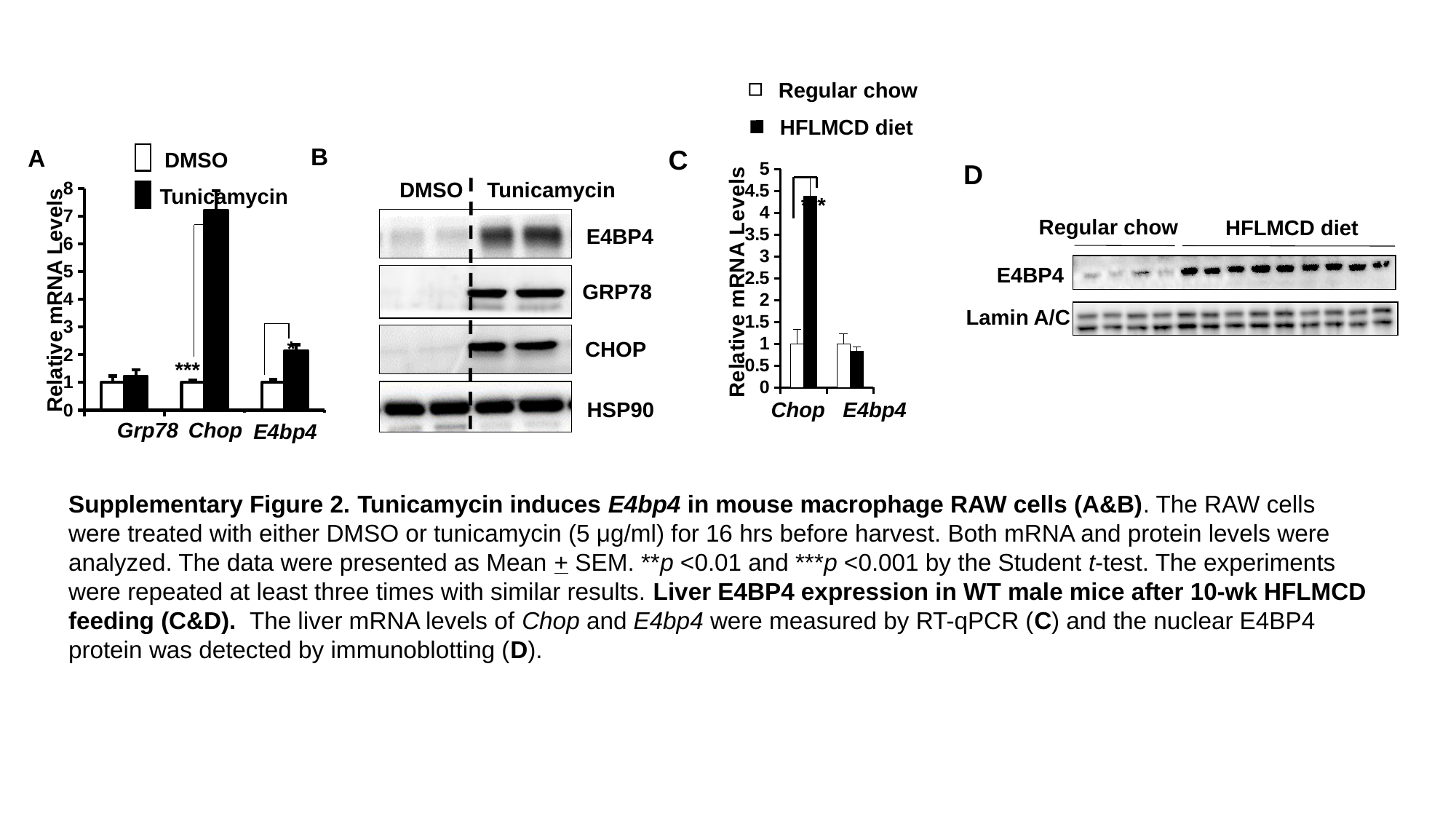
In panel C, is the HFLMCD diet value for Chop greater or less than 4? greater In panel A, what is the label of the y axis? Relative mRNA Levels In panel C, how many gene categories are shown on the x axis? 2 In panel A, what kind of chart is shown? bar chart In panel A, is the Tunicamycin value for E4bp4 greater or less than 3? less In panel C, how many series does the legend list? 2 In panel C, which is larger: the HFLMCD diet value for Chop or the HFLMCD diet value for E4bp4? Chop In panel A, which gene has the highest Tunicamycin value? Chop In panel A, is the Tunicamycin value for Chop greater or less than 6? greater In panel A, how many gene categories are shown on the x axis? 3 In panel A, which is larger: the Tunicamycin value for Chop or the Tunicamycin value for E4bp4? Chop In panel A, how many series does the legend list? 2